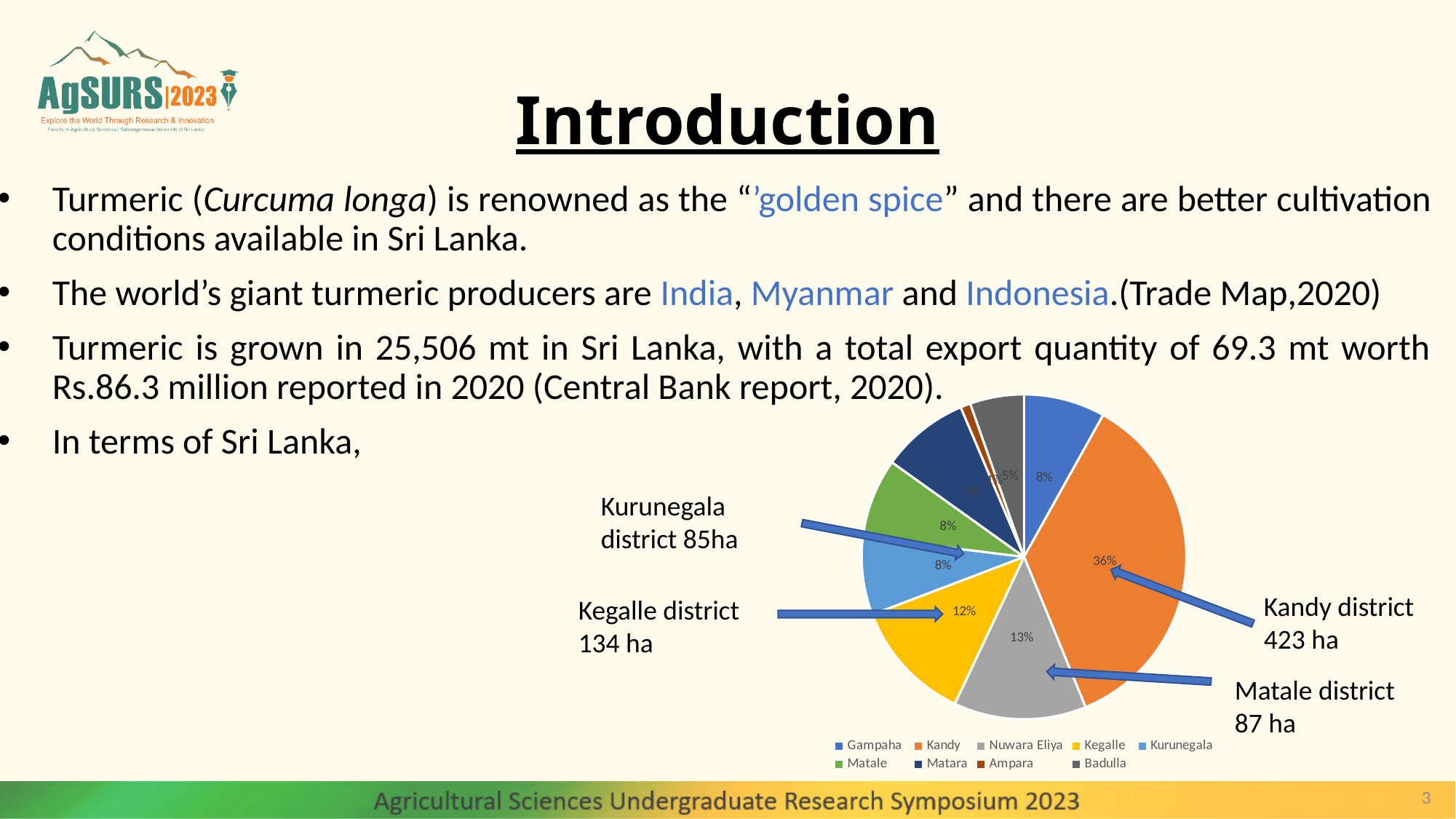
How many districts are listed in the pie chart legend? 9 What percentage share does Kegalle have in the pie chart? 12% What percentage share does Gampaha have in the pie chart? 8% What percentage share does Kandy have in the pie chart? 36% What kind of chart is shown on the slide? pie chart What percentage share does Nuwara Eliya have in the pie chart? 13% By how many percentage points does Kandy's share exceed Nuwara Eliya's share? 23 percentage points Which district has the smallest slice of the pie chart? Ampara What percentage share does Badulla have in the pie chart? 5% Which district has the largest slice of the pie chart? Kandy Which has the larger share in the pie chart, Kegalle or Nuwara Eliya? Nuwara Eliya What colour is the Kandy slice in the pie chart? orange